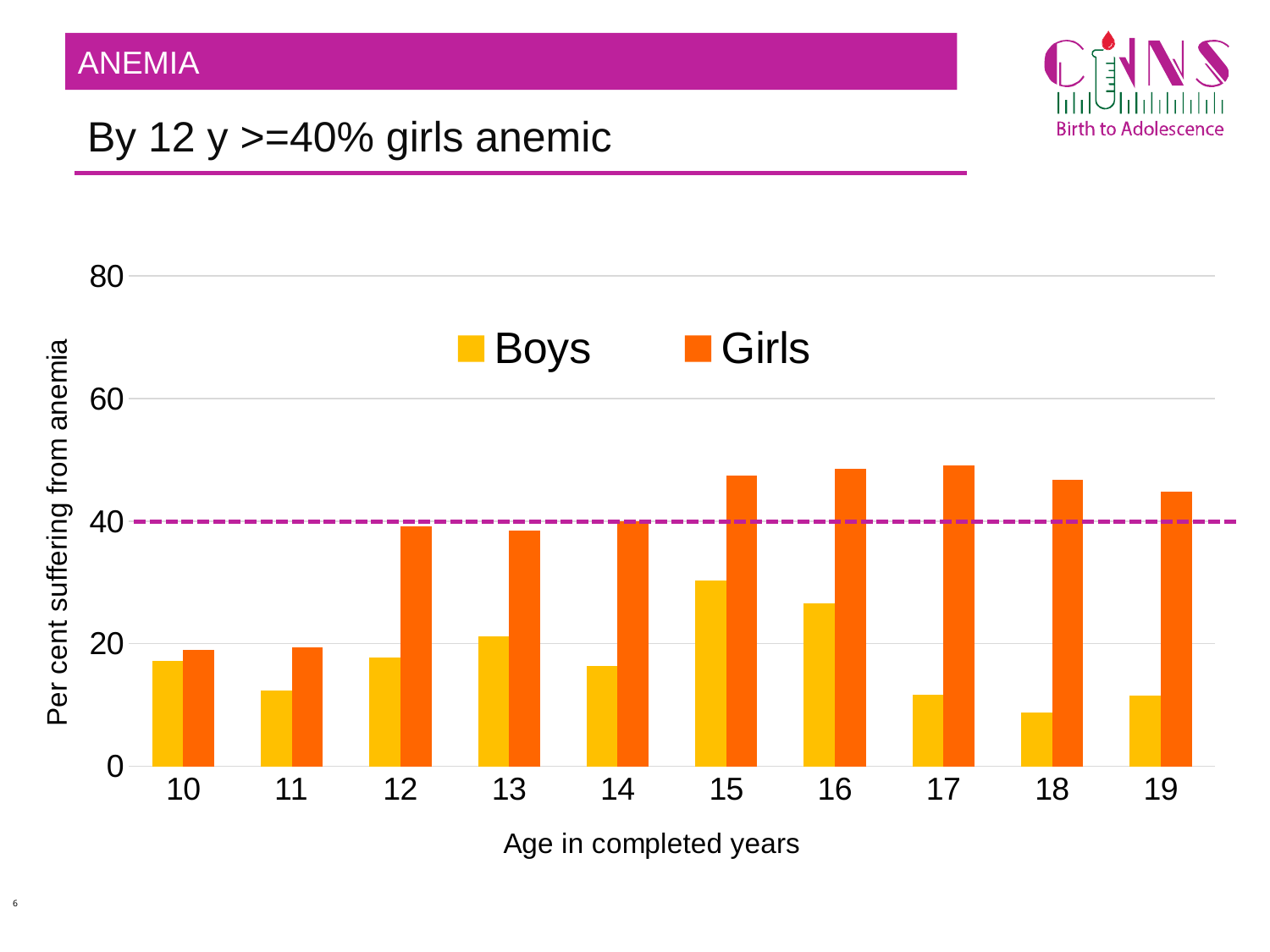
What kind of chart is shown on the slide? bar chart Do the Girls values generally rise or fall from age 10 to age 16? rise Which age has the highest value for Boys? 15 Which age has the lowest value for Boys? 18 Is the value for Boys at age 15 greater or less than 20? greater At what value on the y axis is the horizontal dashed line drawn? 40 Is the value for Boys at age 11 greater or less than 20? less Is the value for Girls at age 15 greater or less than 40? greater How many series does the legend list? 2 At age 17, which is larger, the value for Boys or the value for Girls? Girls How many age categories are shown on the x axis? 10